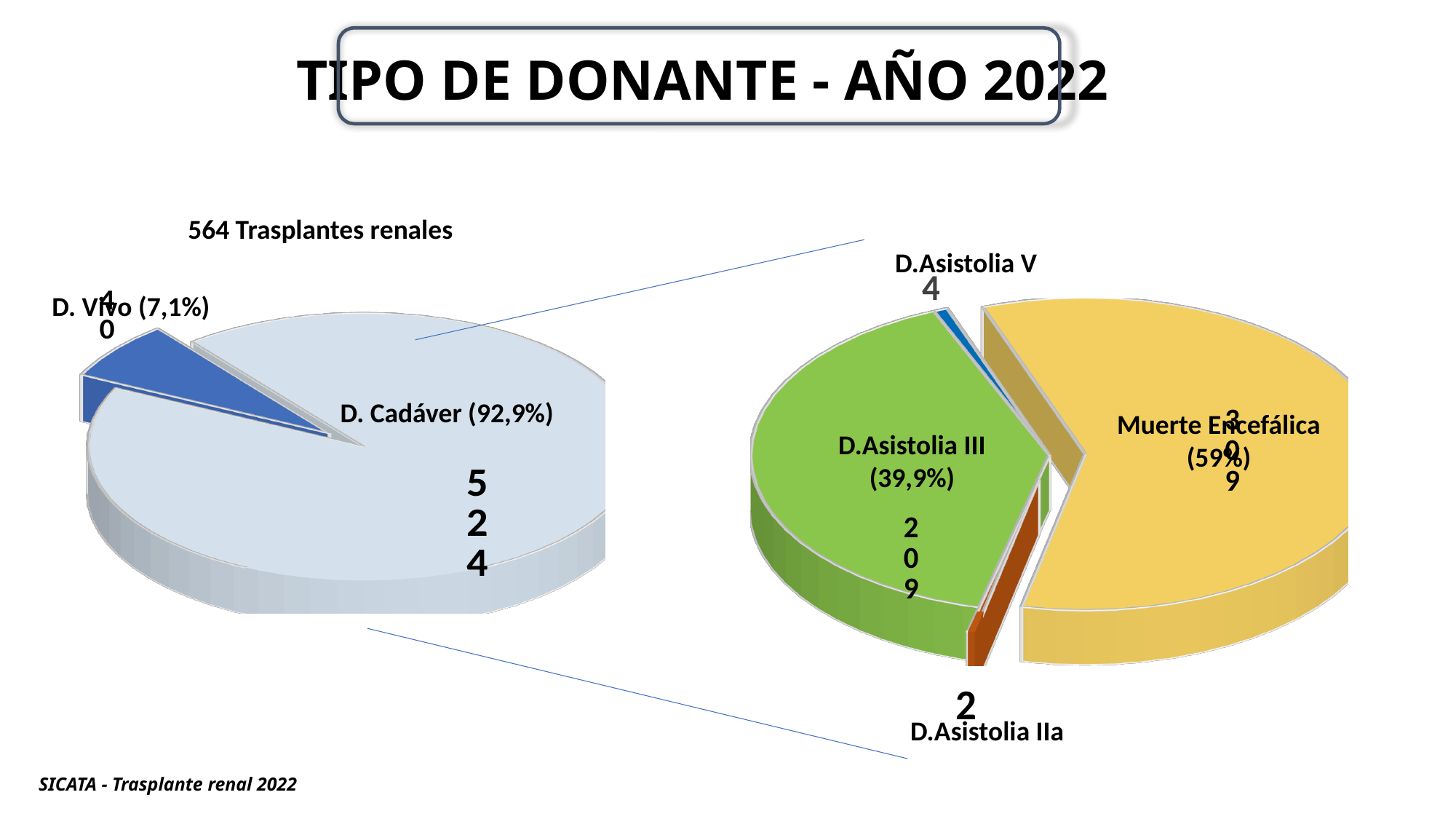
In the right pie chart, what is the value labelled for D.Asistolia V? 4 What type of chart is used on the left side of the slide? Pie chart In the right pie chart, what is the value labelled for D.Asistolia IIa? 2 In the right pie chart, which category has the smallest slice? D.Asistolia IIa In the left pie chart (564 Trasplantes renales), what percentage is shown for D. Cadáver? 92,9% How many categories are shown in the right pie chart? 4 In the right pie chart, what percentage is shown for D.Asistolia III? 39,9% In the left pie chart (564 Trasplantes renales), what percentage is shown for D. Vivo? 7,1% In the left pie chart (564 Trasplantes renales), what is the value labelled for D. Vivo? 40 In the left pie chart (564 Trasplantes renales), which category has the largest slice? D. Cadáver In the left pie chart (564 Trasplantes renales), what is the value labelled for D. Cadáver? 524 In the right pie chart, what percentage is shown for Muerte Encefálica? 59%